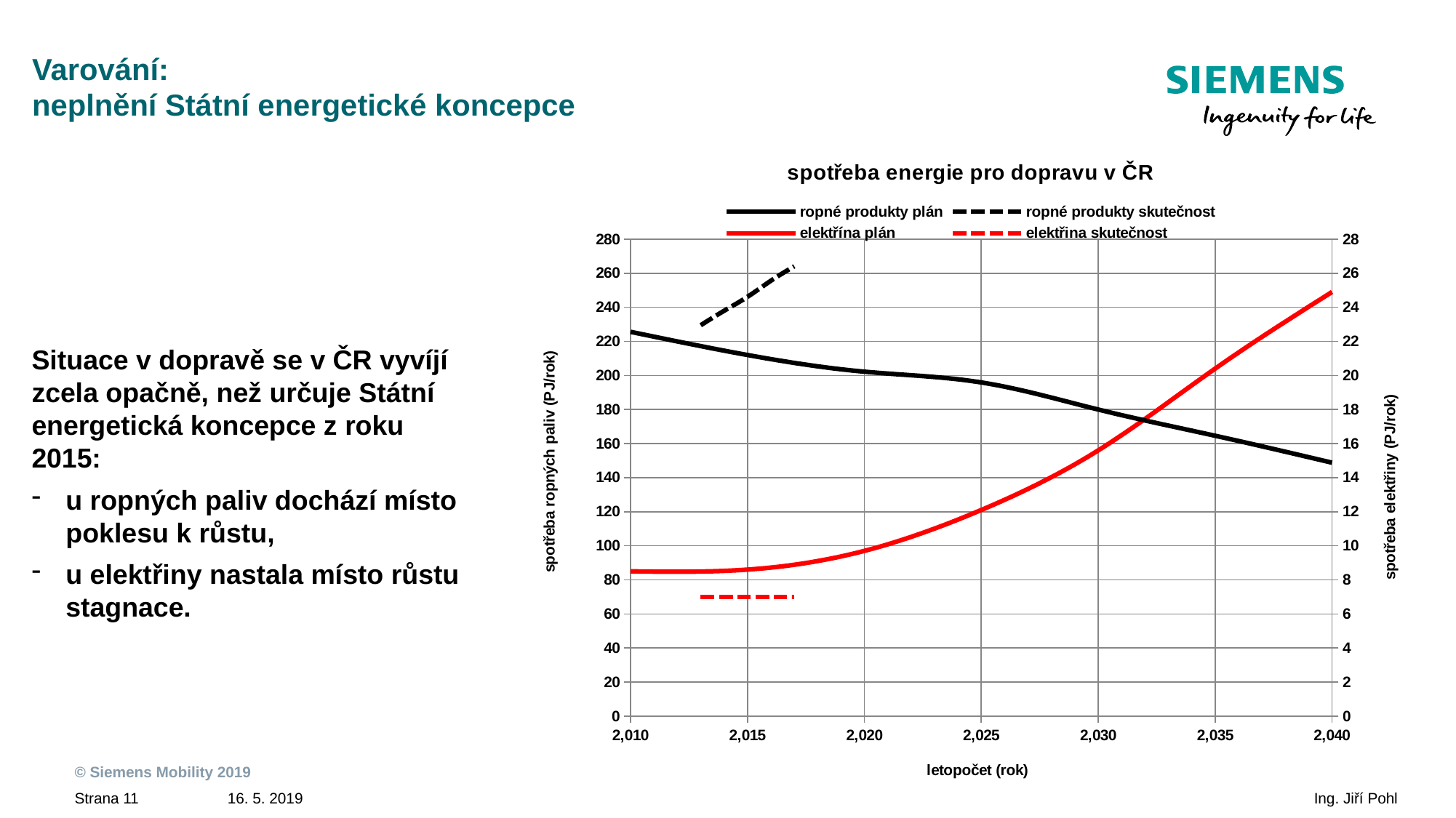
Is the value of 'elektřina plán' in 2010 greater or less than 10 on the right axis? less Does the 'ropné produkty plán' line rise or fall from 2010 to 2040? fall What is the label of the x axis of the chart? letopočet (rok) Is the value of 'ropné produkty plán' in 2040 greater or less than 160 on the left axis? less What is the title of the chart? spotřeba energie pro dopravu v ČR Is the value of 'elektřina plán' in 2040 greater or less than 20 on the right axis? greater Does the dashed 'ropné produkty skutečnost' line rise or fall over the years it covers? rise Does the 'elektřina plán' line rise or fall from 2010 to 2040? rise How many series does the chart legend list? 4 What kind of chart is shown on the slide? line chart For 'ropné produkty plán', which year has the larger value, 2010 or 2040? 2010